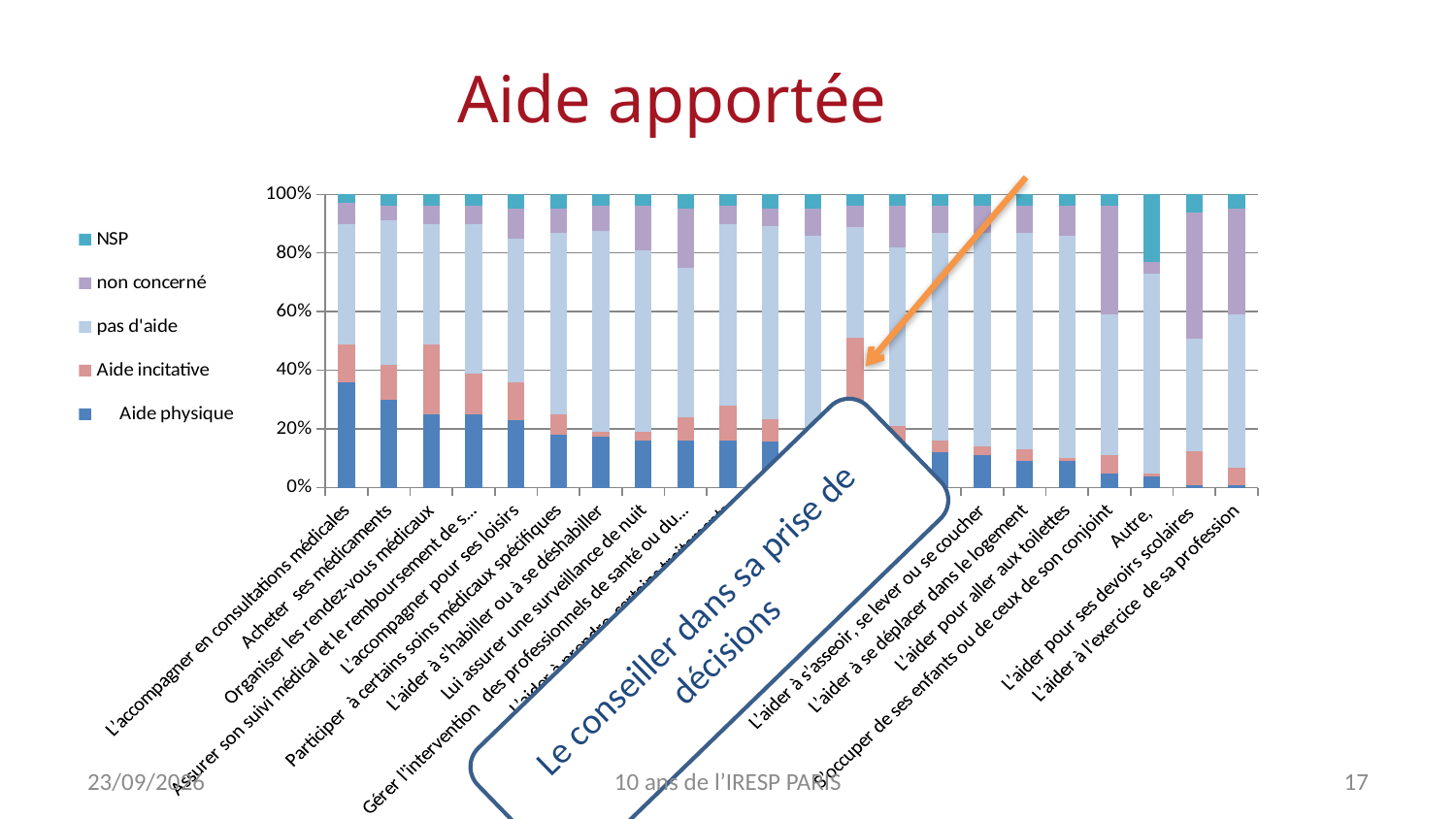
Which category has the largest 'NSP' share? Autre Is the 'pas d'aide' share for 'L'aider pour aller aux toilettes' greater or less than 60%? greater Which legend entry is shown in dark blue at the bottom of each bar? Aide physique Moving from left to right along the x axis, does the 'Aide physique' share generally rise or fall? fall Is the 'Aide physique' share for 'L'accompagner en consultations médicales' greater or less than 20%? greater Which category has the largest 'Aide physique' share? L'accompagner en consultations médicales Which has the larger 'Aide physique' share: 'L'accompagner en consultations médicales' or 'Acheter ses médicaments'? L'accompagner en consultations médicales What kind of chart is shown on the slide? Stacked bar chart Is the 'Aide physique' share for 'L'aider à l'exercice de sa profession' greater or less than 20%? less Which has the larger 'NSP' share: 'Autre' or 'Acheter ses médicaments'? Autre What is the title of the chart? Aide apportée How many series does the legend list? 5